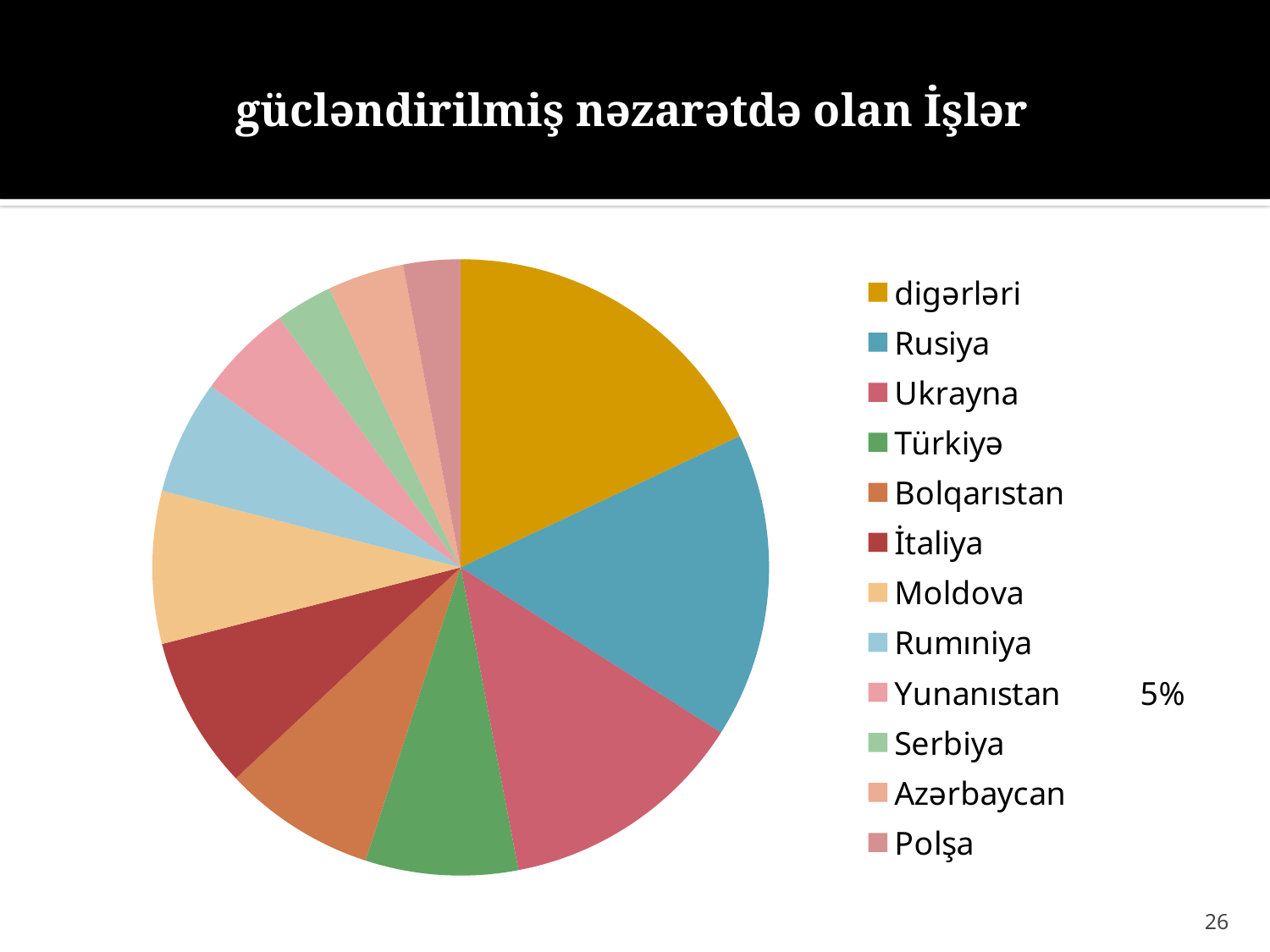
Which slice is larger, Rumıniya or Serbiya? Rumıniya Which category has the largest slice of the pie chart? digərləri Which slice is larger, Rusiya or Türkiyə? Rusiya Which category is listed first in the pie chart's legend? digərləri Which slice is larger, Ukrayna or Moldova? Ukrayna What is the title of the slide containing the pie chart? gücləndirilmiş nəzarətdə olan İşlər How many categories does the pie chart's legend list? 12 What kind of chart is shown on the slide? pie chart What percentage is shown for Yunanıstan? 5%